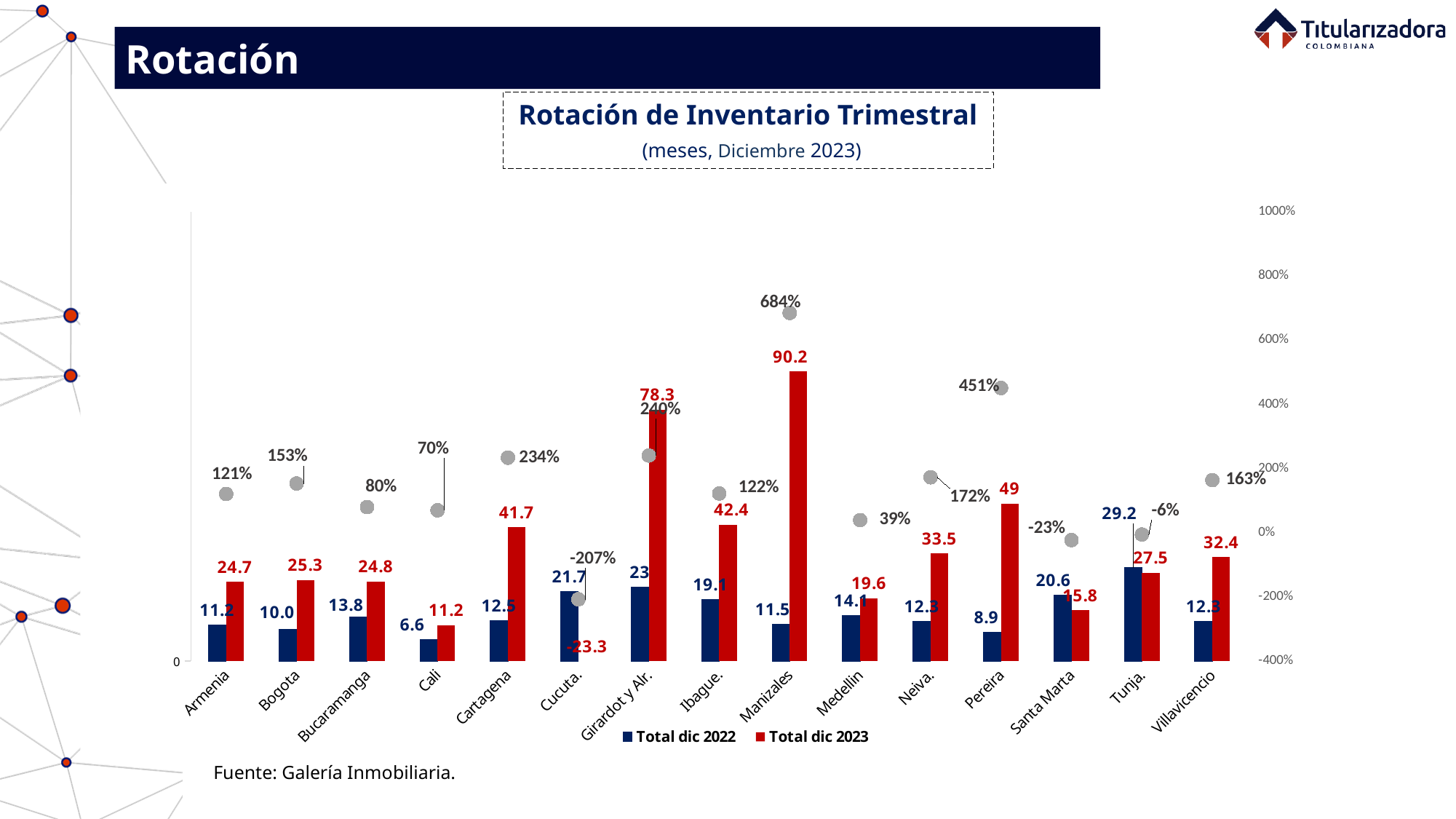
What is the Total dic 2023 value for Manizales? 90.2 Which city has the highest Total dic 2022 value? Tunja. How many series does the legend list? 2 What kind of chart is used to show the Total dic 2022 and Total dic 2023 values? Bar chart Which city has the highest Total dic 2023 value? Manizales For Santa Marta, which is larger: Total dic 2022 or Total dic 2023? Total dic 2022 What is the Total dic 2022 value for Girardot y Alr.? 23 How many cities are shown on the x axis? 15 What is the difference between the Total dic 2023 and Total dic 2022 values for Manizales? 78.7 What percentage change is shown for Pereira? 451% Which city has the lowest Total dic 2022 value? Cali What is the difference between the Total dic 2023 and Total dic 2022 values for Pereira? 40.1